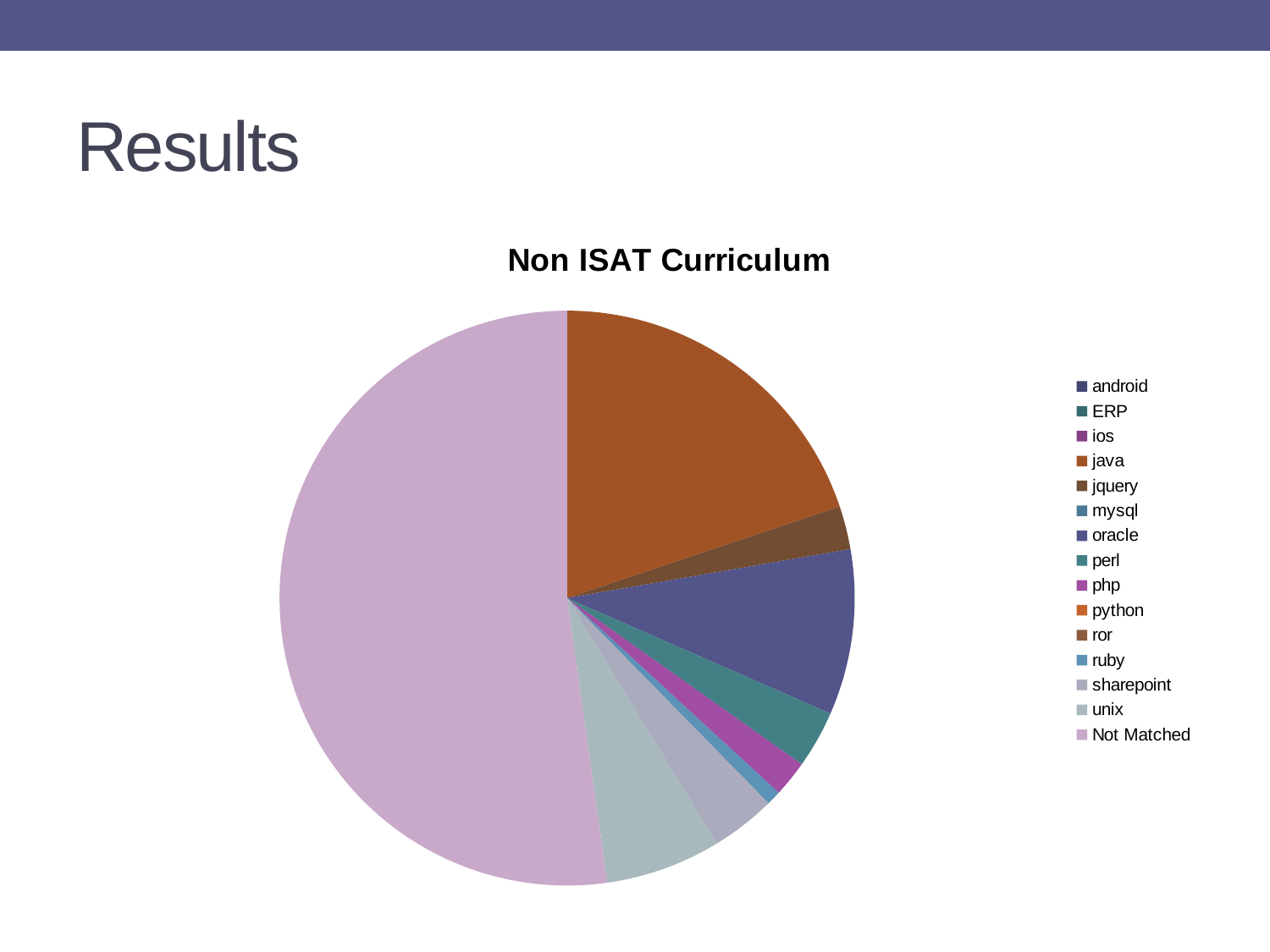
Which legend entry is listed last in the chart's legend? Not Matched How many data series does the pie chart plot? 1 Is the share of the Not Matched slice greater or less than 50%? greater How many categories does the legend of the pie chart list? 15 Which is larger, the Not Matched slice or the android slice? Not Matched Which is larger, the Not Matched slice or the java slice? Not Matched What is the title of the chart? Non ISAT Curriculum What kind of chart is shown on the slide? pie chart Which category has the largest slice of the pie? Not Matched